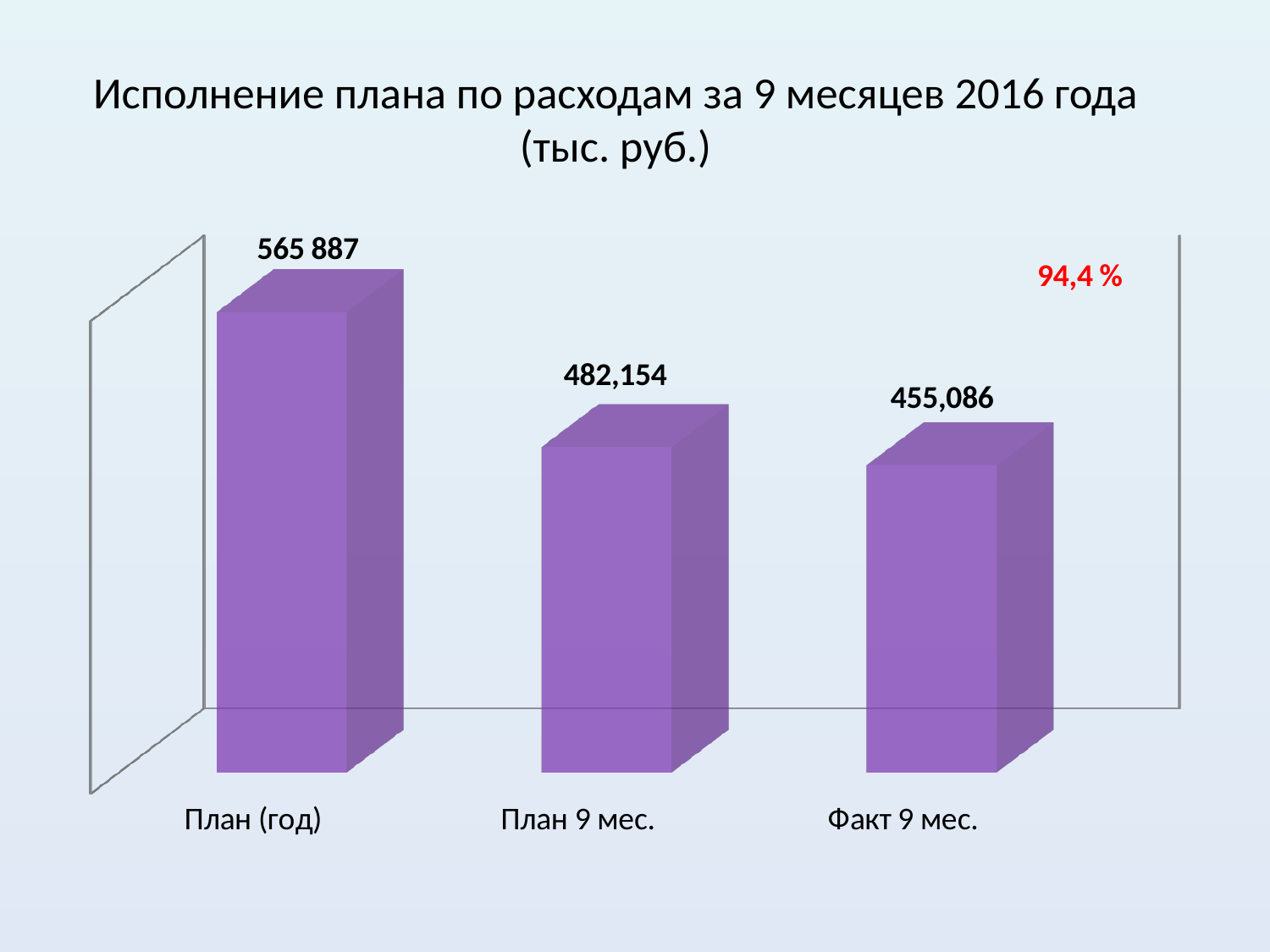
What is the value for План 9 мес.? 482,154 What percentage is shown in red on the chart? 94,4 % What is the difference between План 9 мес. and Факт 9 мес.? 27,068 What is the value for План (год)? 565 887 What kind of chart is shown on the slide? Bar chart What is the title of the chart? Исполнение плана по расходам за 9 месяцев 2016 года (тыс. руб.) Which is larger, План 9 мес. or Факт 9 мес.? План 9 мес. Which category has the lowest value? Факт 9 мес. How many categories are shown in the chart? 3 What is the value for Факт 9 мес.? 455,086 Do the values rise or fall from left to right across the categories? Fall Which category has the highest value? План (год)